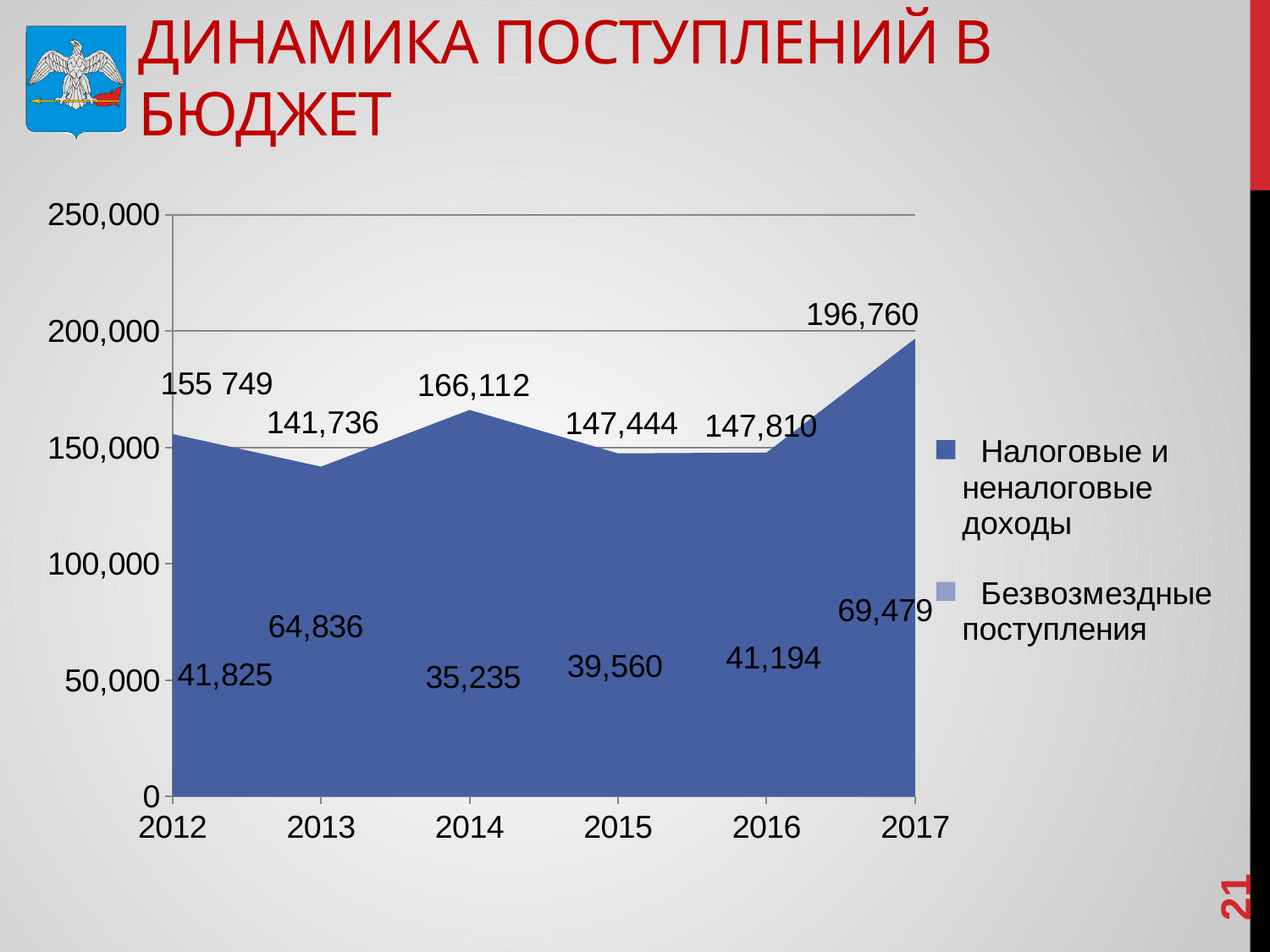
In which year is Налоговые и неналоговые доходы the highest? 2017 What is the difference between Налоговые и неналоговые доходы in 2017 and in 2016? 48,950 How many years are shown on the x axis? 6 What is the value of Налоговые и неналоговые доходы in 2017? 196,760 What is the value of Безвозмездные поступления in 2013? 64,836 How many series does the legend list? 2 Which is larger: Безвозмездные поступления in 2013 or in 2017? 2017 What is the value of Безвозмездные поступления in 2016? 41,194 What is the value of Налоговые и неналоговые доходы in 2014? 166,112 What type of chart is shown on the slide? Area chart In which year is Безвозмездные поступления the lowest? 2014 What is the title of the slide containing the chart? ДИНАМИКА ПОСТУПЛЕНИЙ В БЮДЖЕТ